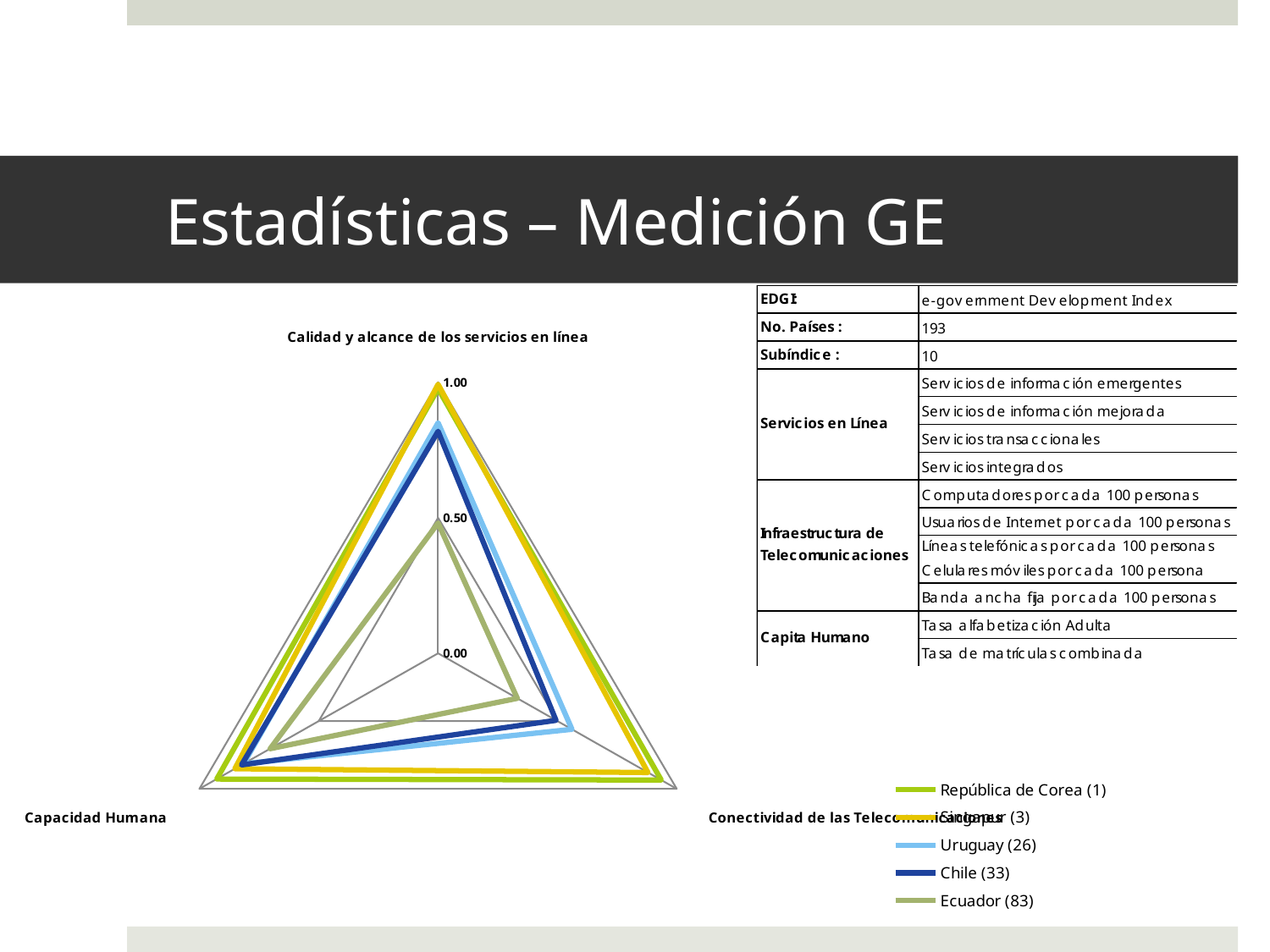
What kind of chart is shown on the left of the slide? radar chart What is the maximum value shown on the radar chart's scale? 1.00 Which is larger on the 'Calidad y alcance de los servicios en línea' axis: República de Corea (1) or Ecuador (83)? República de Corea (1) Which is larger on the 'Capacidad Humana' axis: Chile (33) or Ecuador (83)? Chile (33) Which series has the lowest value on the 'Calidad y alcance de los servicios en línea' axis? Ecuador (83) Which series has the lowest value on the 'Capacidad Humana' axis? Ecuador (83) Is the value for Ecuador (83) on the 'Capacidad Humana' axis greater or less than 0.50? greater How many series does the legend of the radar chart list? 5 Is the value for Chile (33) on the 'Calidad y alcance de los servicios en línea' axis greater or less than 0.50? greater How many axes (categories) does the radar chart have? 3 Is the value for Ecuador (83) on the 'Conectividad de las Telecomunicaciones' axis greater or less than 0.50? less What rank number is shown next to Ecuador in the legend of the radar chart? 83